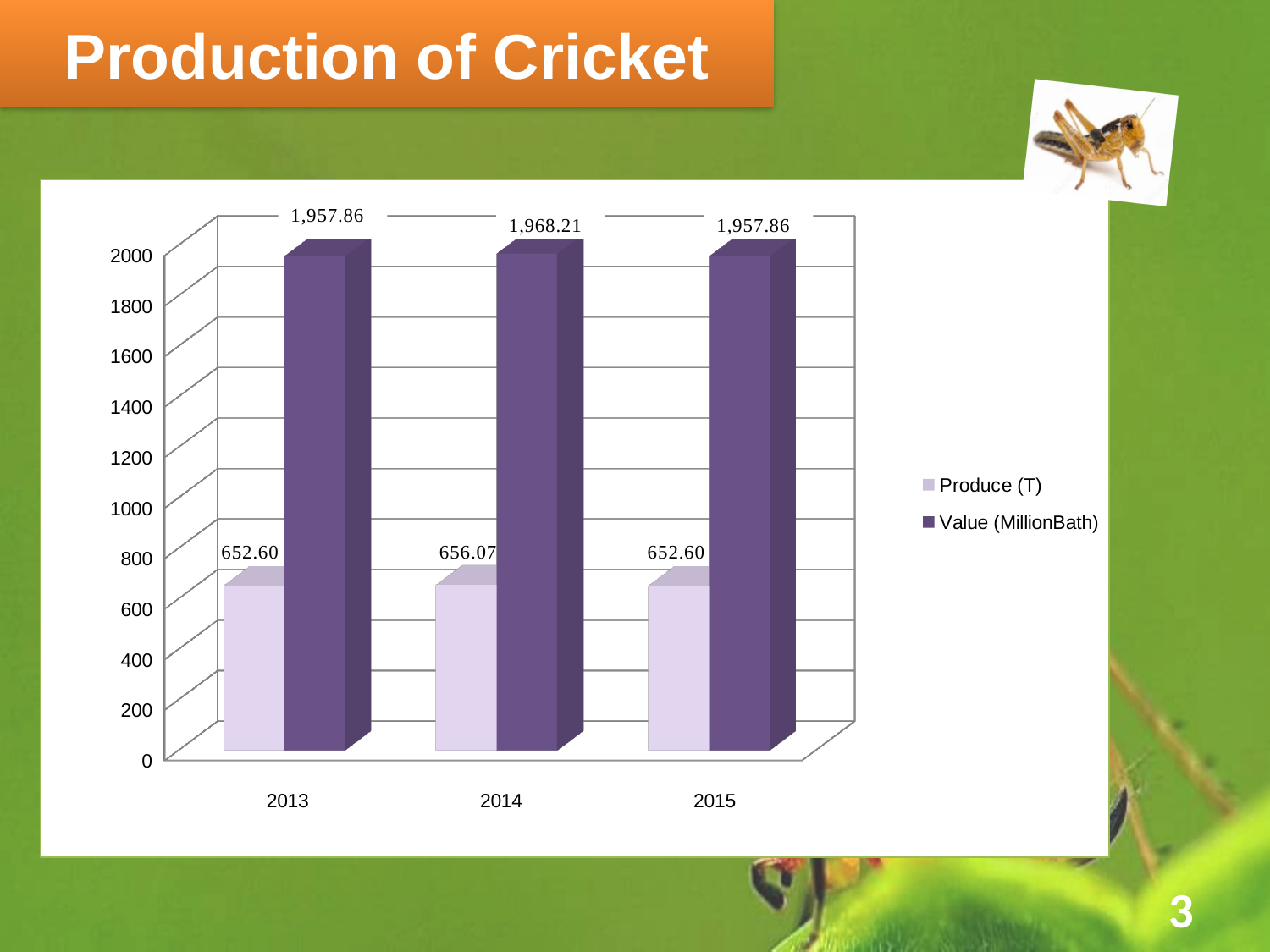
What is the difference between the Value (MillionBath) for 2014 and for 2013? 10.35 According to the data labels, in which year is Value (MillionBath) highest? 2014 In 2015, which is larger: Produce (T) or Value (MillionBath)? Value (MillionBath) What is the Produce (T) for 2014? 656.07 What is the difference between Produce (T) for 2014 and for 2015? 3.47 How many years are shown on the x axis? 3 What is the Value (MillionBath) for 2014? 1,968.21 What is the title of the slide containing the chart? Production of Cricket What is the Produce (T) for 2013? 652.60 How many series does the legend list? 2 What kind of chart is shown on the slide? bar chart Is the Produce (T) value for 2013 greater or less than 800? less